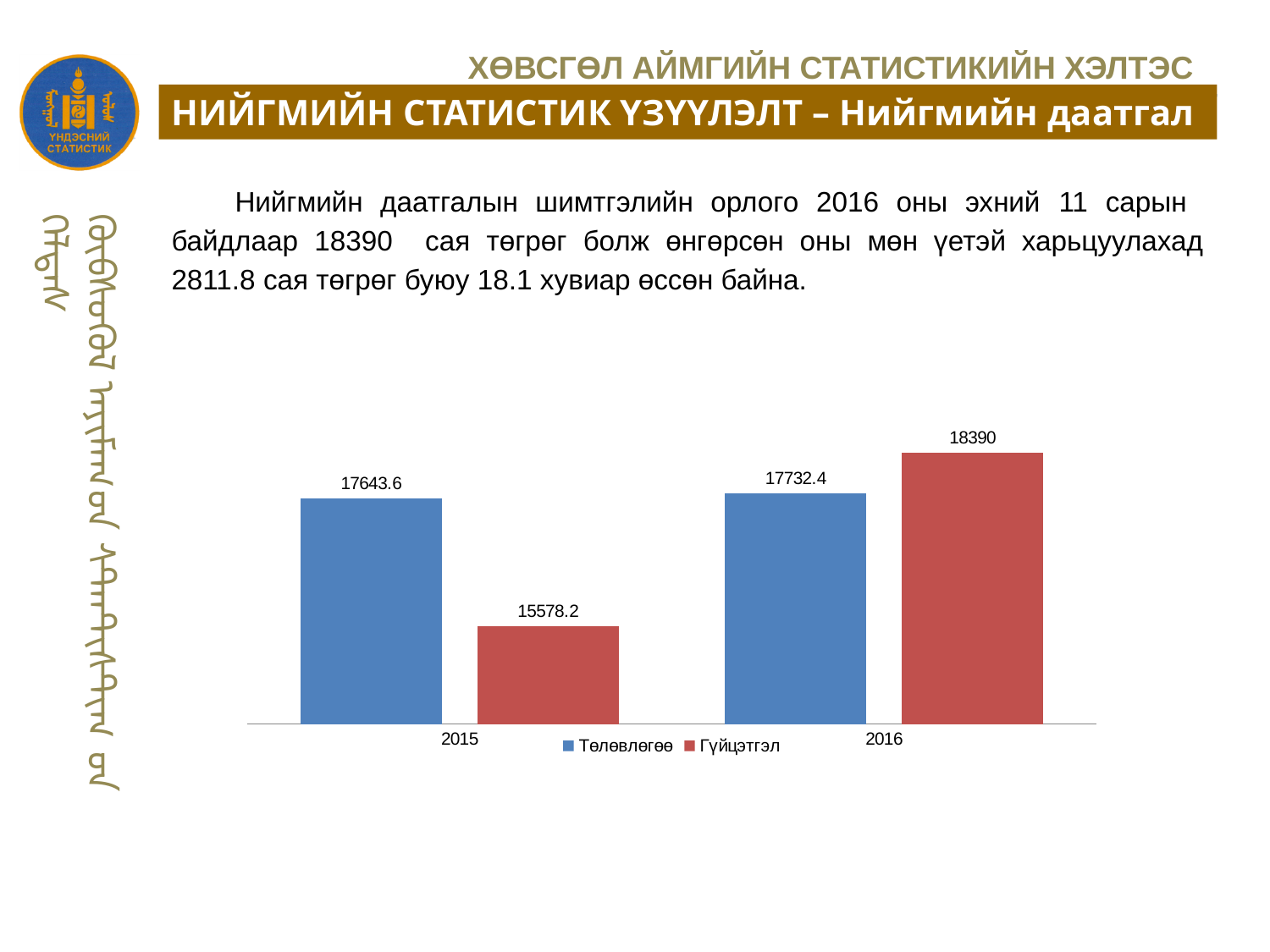
How many year categories are shown on the x axis? 2 What is the Төлөвлөгөө value for 2016? 17732.4 What type of chart is shown on the slide? Bar chart Which bar has the highest value in the chart? Гүйцэтгэл 2016 What is the Гүйцэтгэл value for 2015? 15578.2 What is the difference between the Төлөвлөгөө and Гүйцэтгэл values for 2015? 2065.4 What is the Гүйцэтгэл value for 2016? 18390 What is the difference between the Гүйцэтгэл values for 2016 and 2015? 2811.8 What is the Төлөвлөгөө value for 2015? 17643.6 How many series does the legend list? 2 In 2016, which is larger: Төлөвлөгөө or Гүйцэтгэл? Гүйцэтгэл Which bar has the lowest value in the chart? Гүйцэтгэл 2015